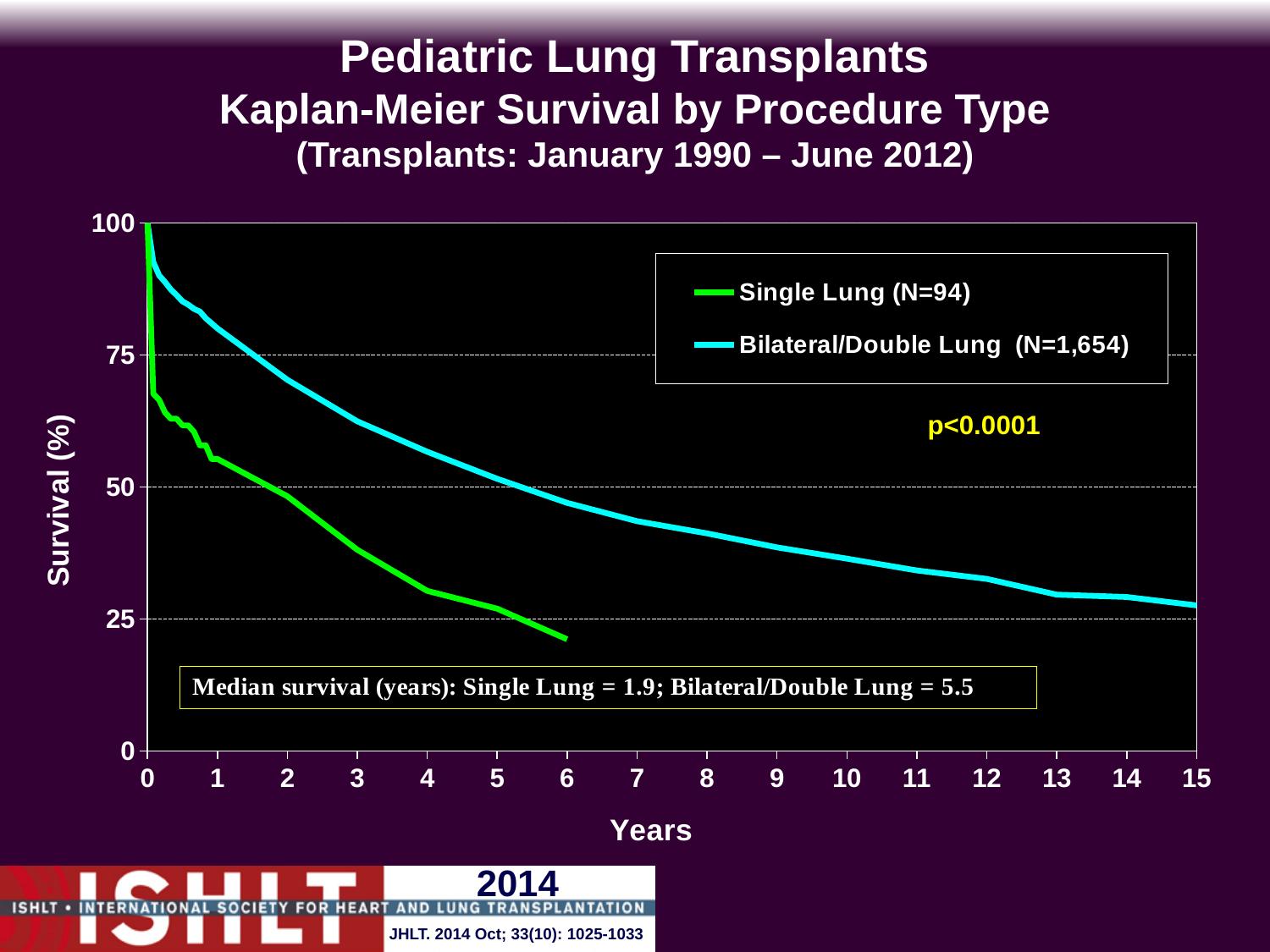
Is the survival for Bilateral/Double Lung at 10 years greater or less than 25%? greater What is the median survival in years for Bilateral/Double Lung? 5.5 What p-value is shown on the chart? p<0.0001 What is the difference in median survival (years) between Bilateral/Double Lung and Single Lung? 3.6 What is the median survival in years for Single Lung? 1.9 How many series does the legend list? 2 What kind of chart is shown on the slide? line chart Is the survival for Single Lung at 3 years greater or less than 50%? less What is the N for the Bilateral/Double Lung group shown in the legend? 1,654 What is the N for the Single Lung group shown in the legend? 94 Do the survival curves rise or fall as years increase? fall Which procedure type has the higher survival at 5 years, Single Lung or Bilateral/Double Lung? Bilateral/Double Lung